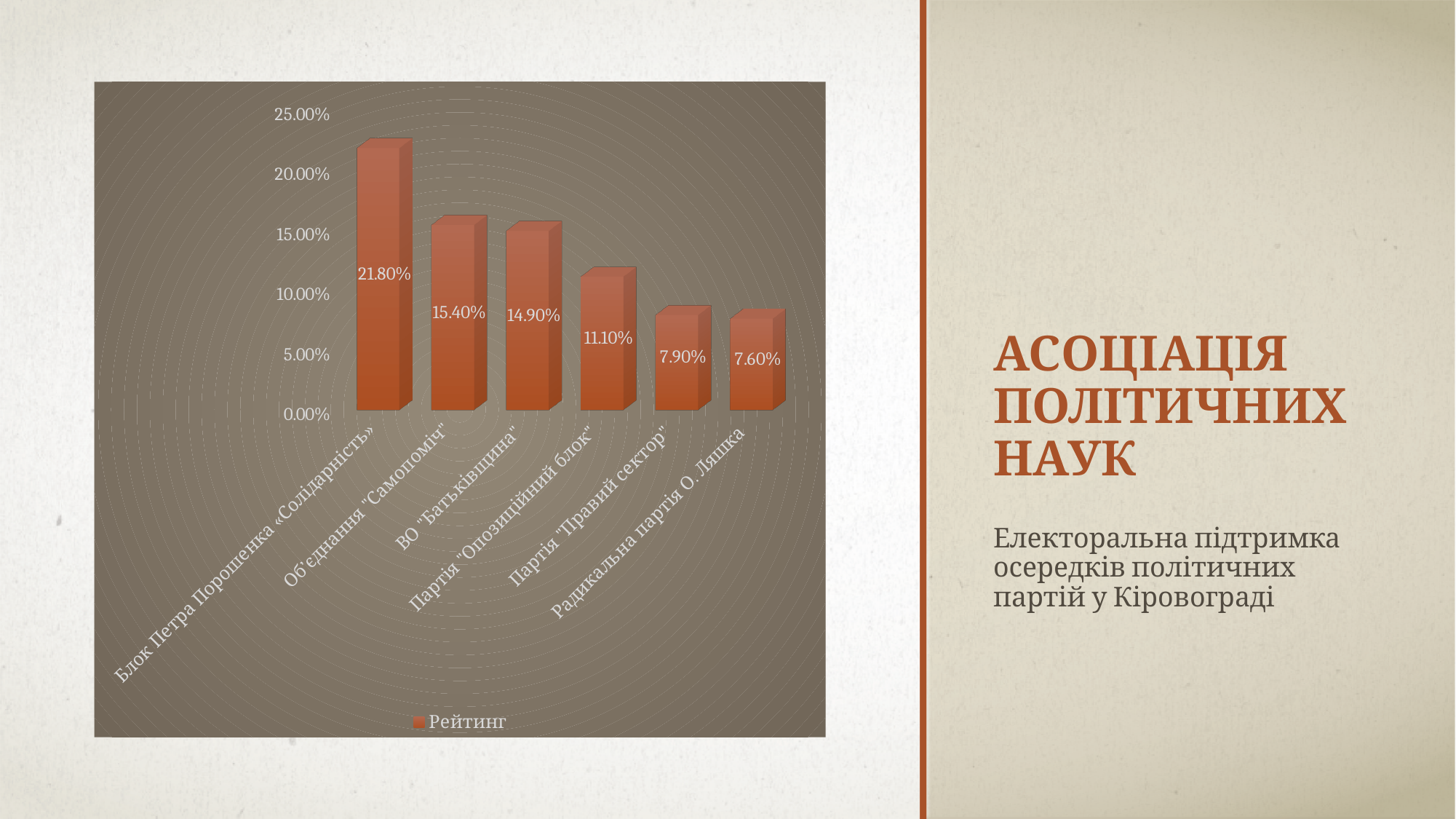
What is the value for ВО "Батьківщина"? 14.90% What is the value for Партія "Опозиційний блок"? 11.10% How many series does the legend list? 1 Which category has the highest value? Блок Петра Порошенка «Солідарність» What is the value for Радикальна партія О. Ляшка? 7.60% Which is larger, the value for Об'єднання "Самопоміч" or the value for Партія "Опозиційний блок"? Об'єднання "Самопоміч" What is the difference between the values for Блок Петра Порошенка «Солідарність» and Об'єднання "Самопоміч"? 6.40% What is the name of the series shown in the legend? Рейтинг How many categories are shown in the chart? 6 What is the value for Блок Петра Порошенка «Солідарність»? 21.80% What kind of chart is shown on the slide? Bar chart Which category has the lowest value? Радикальна партія О. Ляшка